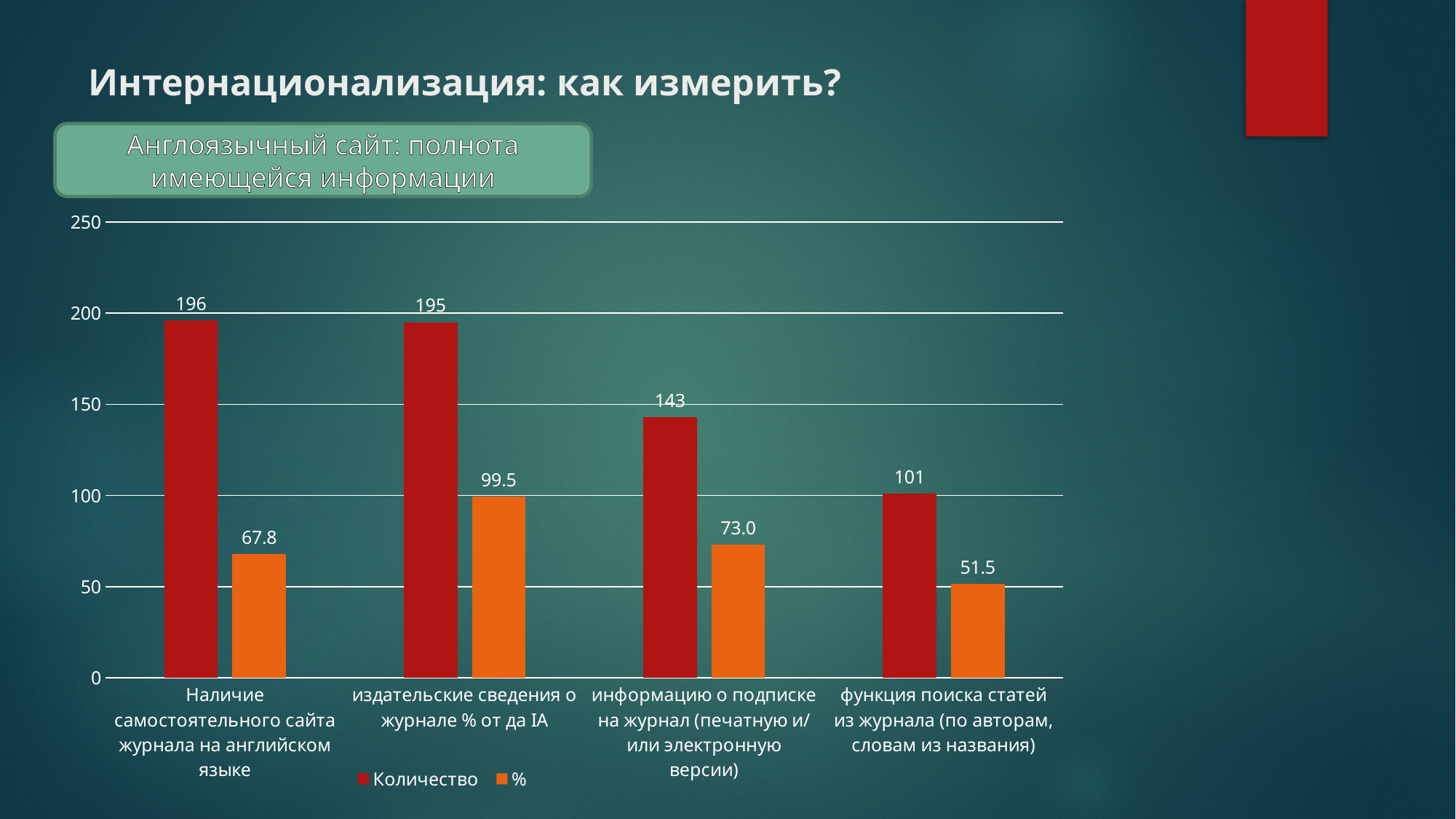
Сколько категорий показано на диаграмме? 4 Какое значение серии «Количество» для категории «Наличие самостоятельного сайта журнала на английском языке»? 196 Какого типа эта диаграмма? Столбчатая (bar chart) В какой категории значение серии «Количество» наименьшее? функция поиска статей из журнала (по авторам, словам из названия) В какой категории значение серии «%» наибольшее? издательские сведения о журнале % от да IA Сколько серий перечислено в легенде диаграммы? 2 Какое значение серии «%» для категории «информацию о подписке на журнал (печатную и/или электронную версии)»? 73.0 Как называется диаграмма (заголовок в зелёной рамке)? Англоязычный сайт: полнота имеющейся информации Какое значение серии «Количество» для категории «функция поиска статей из журнала (по авторам, словам из названия)»? 101 На сколько значение «Количество» для категории «издательские сведения о журнале % от да IA» больше, чем для категории «информацию о подписке на журнал (печатную и/или электронную версии)»? 52 Что больше: значение «%» для категории «Наличие самостоятельного сайта журнала на английском языке» или для категории «функция поиска статей из журнала (по авторам, словам из названия)»? Наличие самостоятельного сайта журнала на английском языке Какое значение серии «%» для категории «издательские сведения о журнале % от да IA»? 99.5